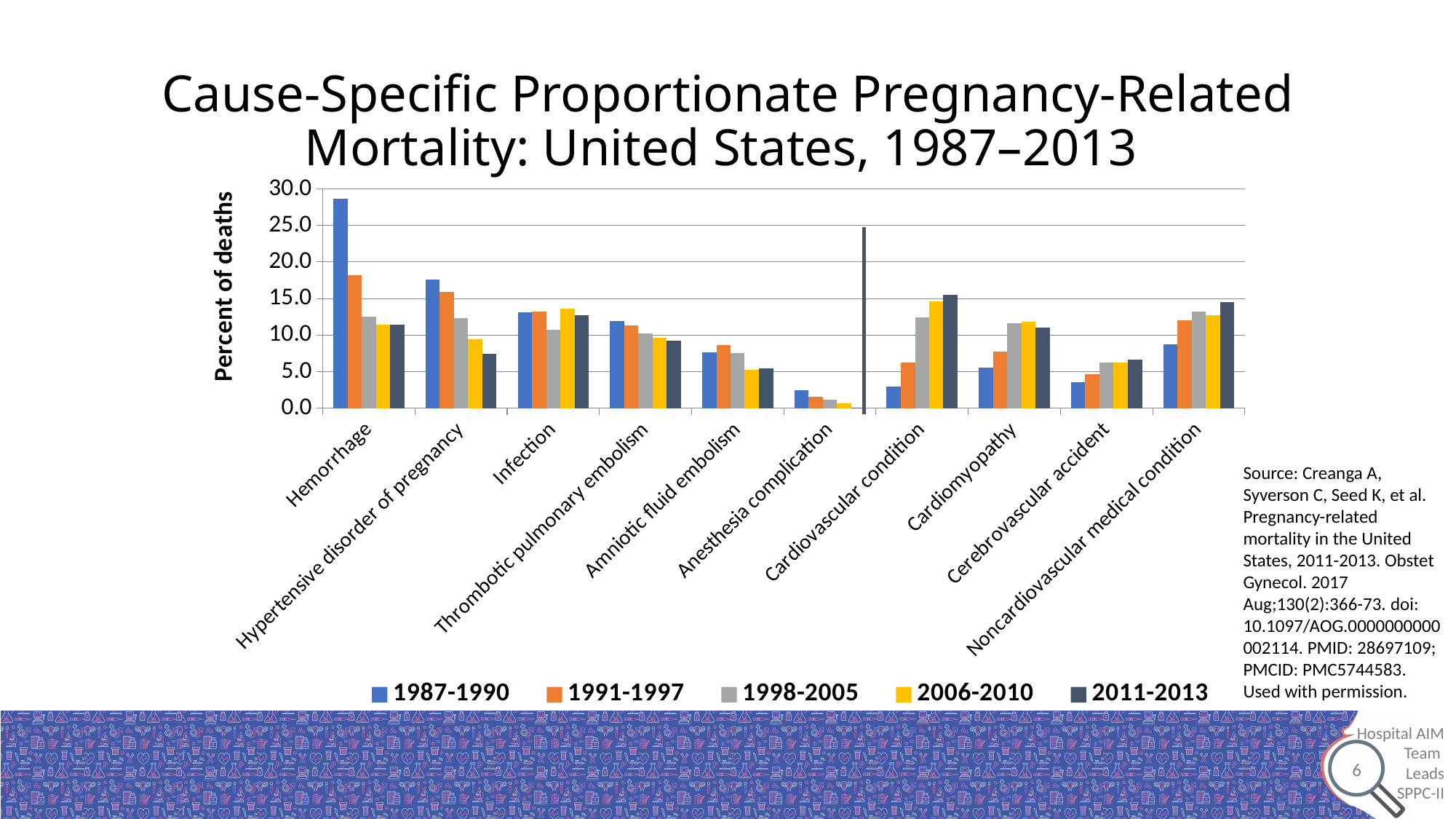
What type of chart is shown on the slide? bar chart Do the values for Hemorrhage rise or fall from the 1987-1990 series to the 2011-2013 series? fall Which cause has the lowest value for the 2011-2013 series? Anesthesia complication For the 2006-2010 series, which is larger: Infection or Hemorrhage? Infection Is the value for Hypertensive disorder of pregnancy in 1987-1990 greater or less than 15.0? greater How many cause categories are shown on the x axis? 10 Which cause has the highest value for the 1987-1990 series? Hemorrhage Is the value for Hemorrhage in 1987-1990 greater or less than 25.0? greater How many series does the legend list? 5 What is the label of the y axis? Percent of deaths Is the value for Cerebrovascular accident in 1987-1990 greater or less than 5.0? less Which time period does the legend list last? 2011-2013